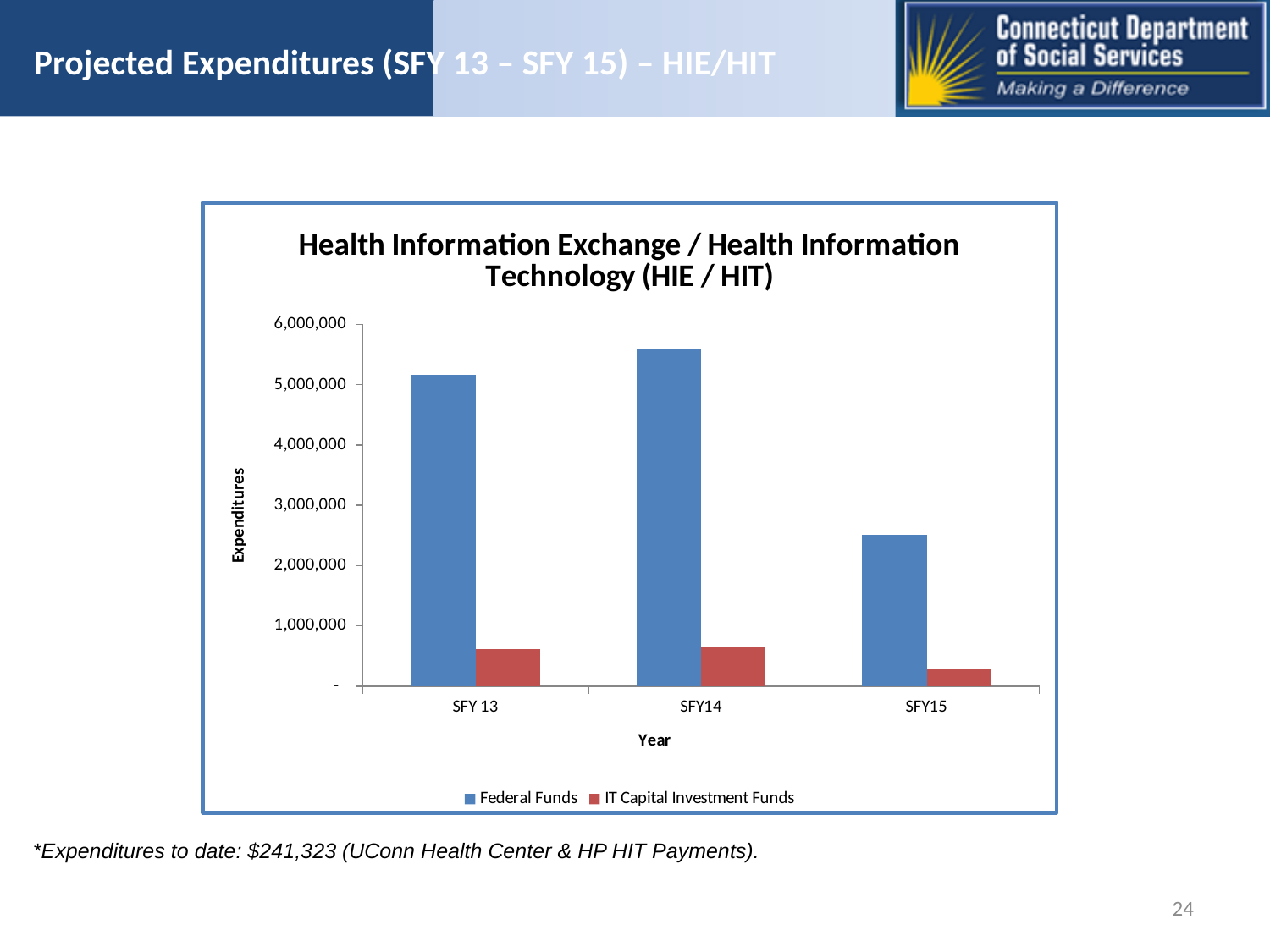
Which is larger for Federal Funds: SFY14 or SFY15? SFY14 What kind of chart is shown on the slide? bar chart Which year has the lowest Federal Funds expenditure? SFY15 Which year has the lowest IT Capital Investment Funds expenditure? SFY15 Which year has the highest Federal Funds expenditure? SFY14 Which is larger in SFY15: Federal Funds or IT Capital Investment Funds? Federal Funds What is the label of the vertical axis of the chart? Expenditures Is the Federal Funds value for SFY 13 greater or less than 5,000,000? greater How many series does the chart's legend list? 2 Is the IT Capital Investment Funds value for SFY14 greater or less than 1,000,000? less How many years are shown on the x axis of the chart? 3 Is the Federal Funds value for SFY15 greater or less than 3,000,000? less